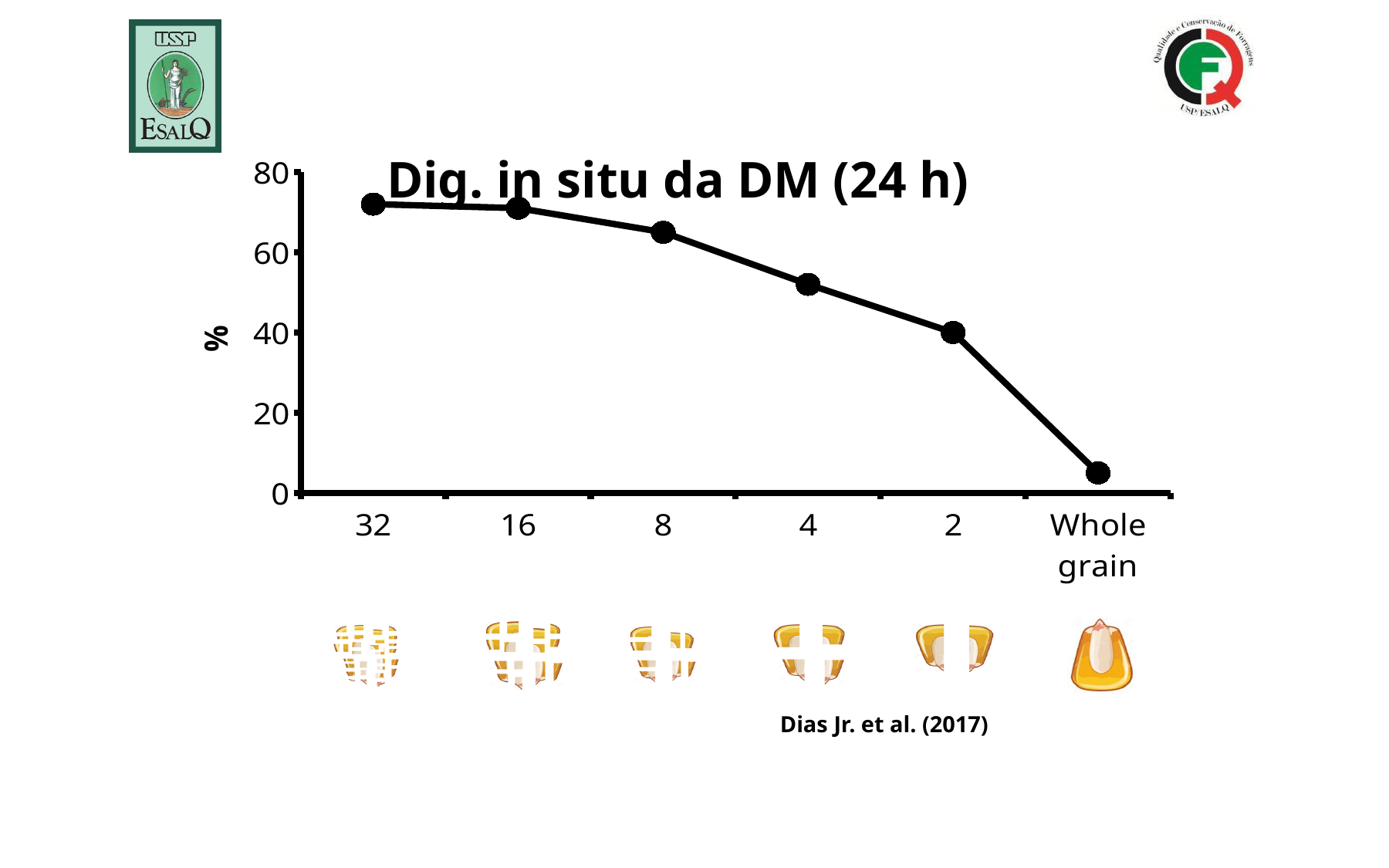
Is the value for 32 greater or less than 60? greater Is the value for 4 greater or less than 40? greater Is the value for Whole grain greater or less than 20? less Which category has the lowest value? Whole grain What is the label on the y axis? % How many data points are plotted on the line? 6 Do the values rise or fall moving from 32 to Whole grain along the x axis? fall What kind of chart is shown on the slide? line chart What is the title of the chart? Dig. in situ da DM (24 h) Which has the larger value, 2 or Whole grain? 2 Which has the larger value, 8 or 4? 8